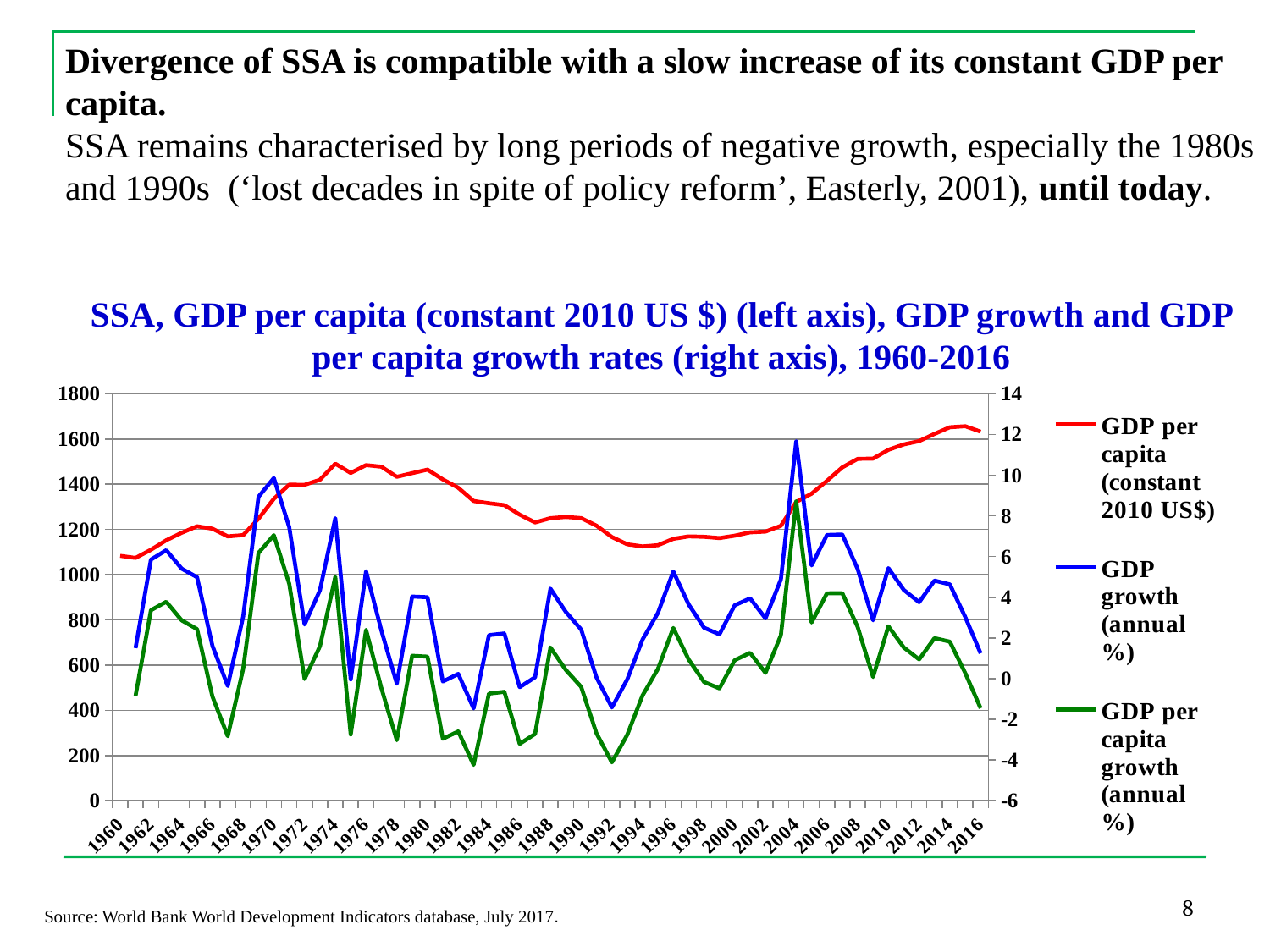
Which series are plotted against the right axis? GDP growth (annual %) and GDP per capita growth (annual %) Is the value of GDP growth (annual %) in 2004 greater or less than 10? greater In which year does GDP growth (annual %) reach its highest value? 2004 Is the value of GDP per capita (constant 2010 US$) in 2016 greater or less than 1400? greater Does GDP per capita (constant 2010 US$) rise or fall between 1994 and 2016? rise Which series is drawn in red? GDP per capita (constant 2010 US$) What kind of chart is shown on the slide? line chart Is the value of GDP per capita growth (annual %) in 1992 greater or less than -2? less How many series does the legend list? 3 Which is larger, GDP per capita (constant 2010 US$) in 1976 or in 1994? 1976